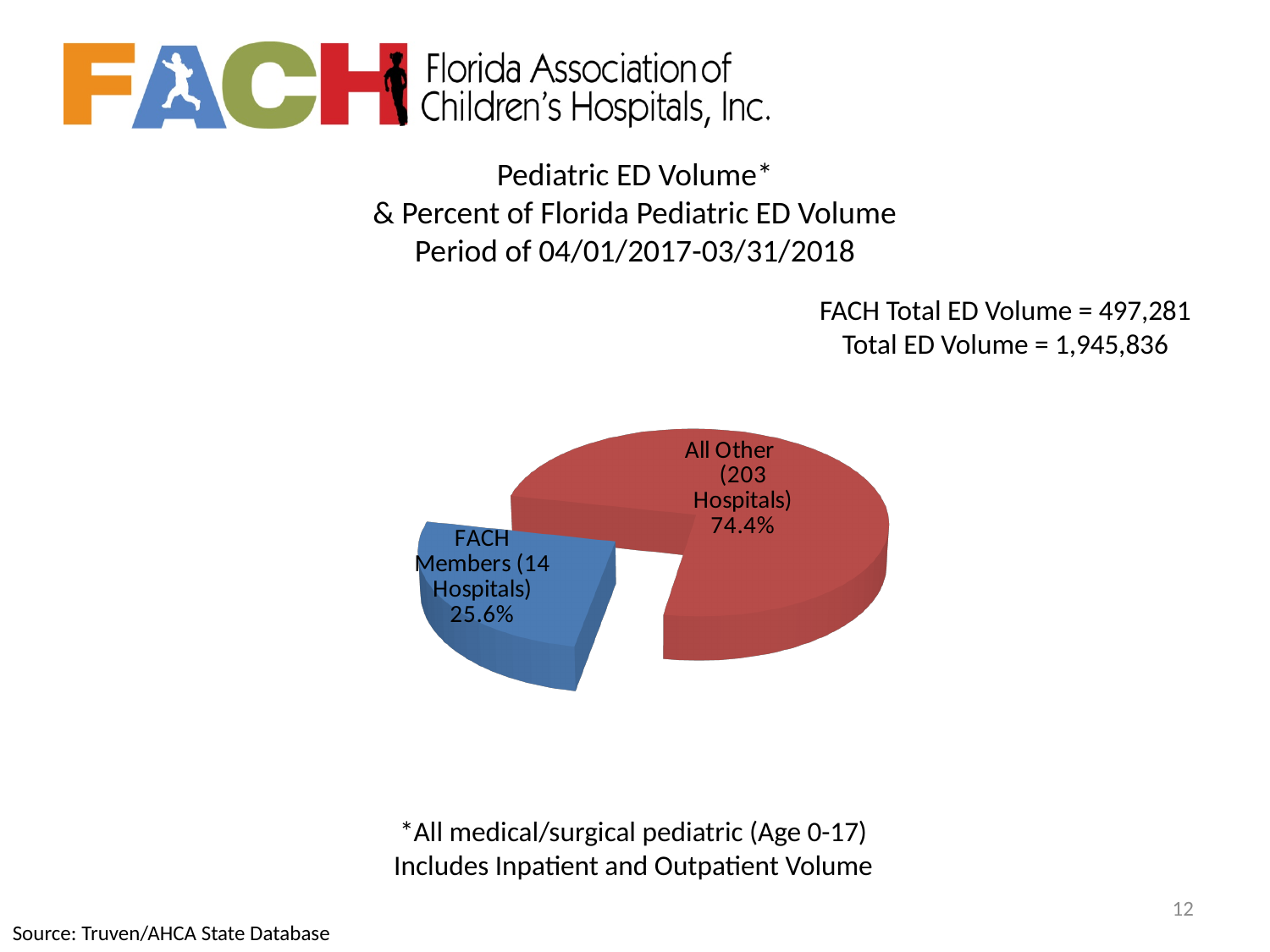
What is the difference in percentage points between the All Other slice and the FACH Members slice? 48.8 Which slice of the pie is the largest? All Other (203 Hospitals) What share of Florida pediatric ED volume is attributed to FACH Members (14 Hospitals)? 25.6% What colour is the FACH Members (14 Hospitals) slice? blue Which slice of the pie is the smallest? FACH Members (14 Hospitals) What colour is the All Other (203 Hospitals) slice? red What share of Florida pediatric ED volume is attributed to All Other (203 Hospitals)? 74.4% How many slices does the pie chart have? 2 Which is larger, the FACH Members slice or the All Other slice? All Other How many hospitals are included in the FACH Members slice? 14 How many hospitals are included in the All Other slice? 203 What kind of chart is shown on the slide? pie chart